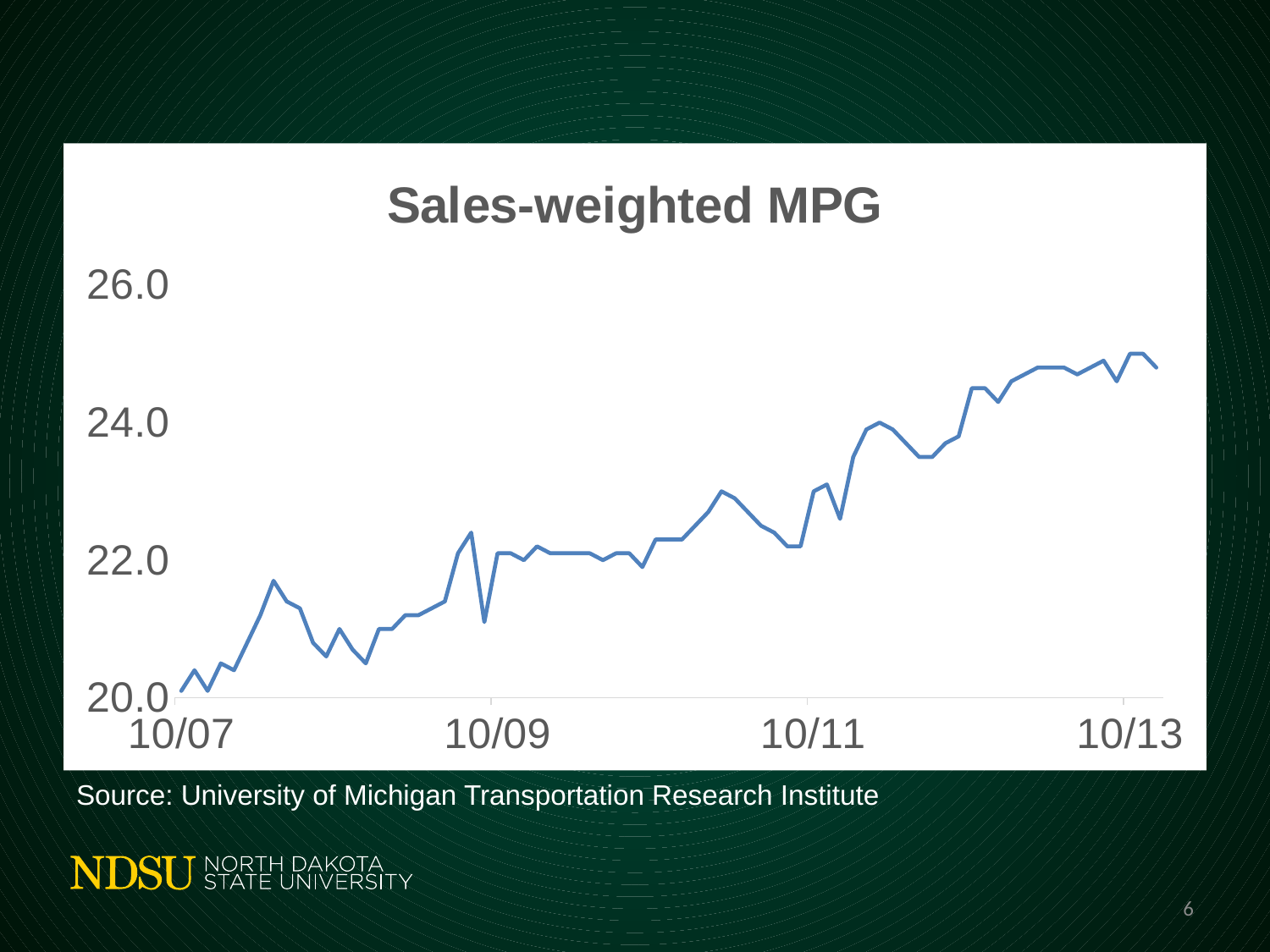
What is the highest value shown on the vertical axis? 26.0 Is the value at 10/11 greater or less than 24.0? less What kind of chart is shown on the slide? line chart Which is larger, the value at 10/11 or the value at 10/13? 10/13 Is the value at 10/07 greater or less than 22.0? less Do the values generally rise or fall from 10/07 to 10/13? rise Is the lowest value on the chart greater or less than 22.0? less What is the title of the chart? Sales-weighted MPG Which is larger, the value at 10/07 or the value at 10/13? 10/13